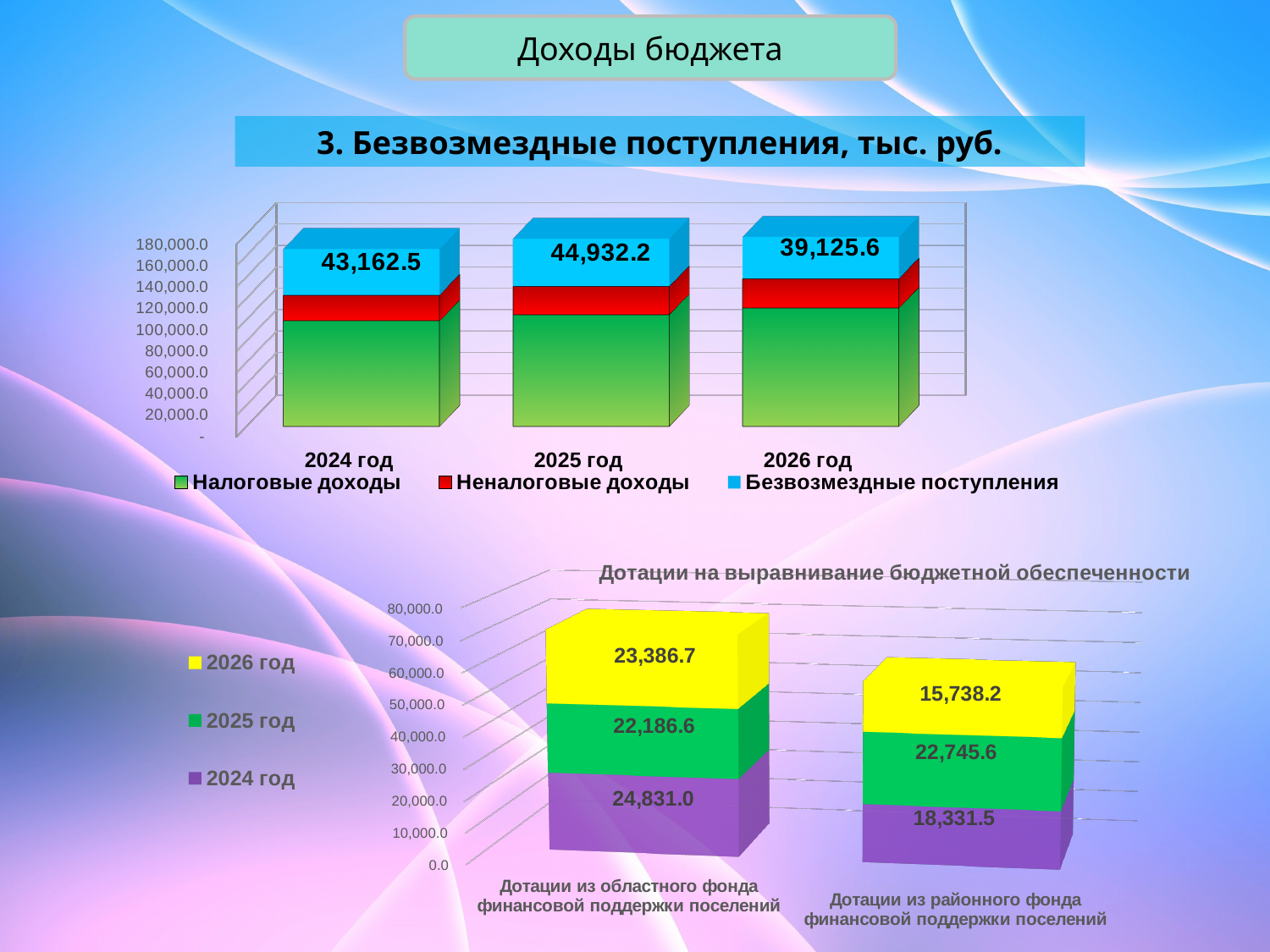
In the top chart, what is the value of Безвозмездные поступления for 2024 год? 43,162.5 What kind of chart is the bottom chart on the slide? Stacked bar chart In the chart titled 'Дотации на выравнивание бюджетной обеспеченности', which is larger for 2026 год: Дотации из областного фонда or Дотации из районного фонда? Дотации из областного фонда финансовой поддержки поселений In the top chart, what is the value of Безвозмездные поступления for 2026 год? 39,125.6 In the chart titled 'Дотации на выравнивание бюджетной обеспеченности', what is the 2024 год value for Дотации из областного фонда финансовой поддержки поселений? 24,831.0 In the top chart, which year has the highest value of Безвозмездные поступления? 2025 год In the top chart, how many series does the legend list? 3 In the top chart, what is the difference between the Безвозмездные поступления values for 2025 год and 2026 год? 5,806.6 In the chart titled 'Дотации на выравнивание бюджетной обеспеченности', what is the 2025 год value for Дотации из районного фонда финансовой поддержки поселений? 22,745.6 In the top chart, is the total stacked bar for 2024 год greater or less than 140,000.0? greater In the chart titled 'Дотации на выравнивание бюджетной обеспеченности', what is the total of the stacked bar for Дотации из областного фонда финансовой поддержки поселений? 70,404.3 In the chart titled 'Дотации на выравнивание бюджетной обеспеченности', what is the difference between the 2024 год values for the областной фонд and the районный фонд? 6,499.5